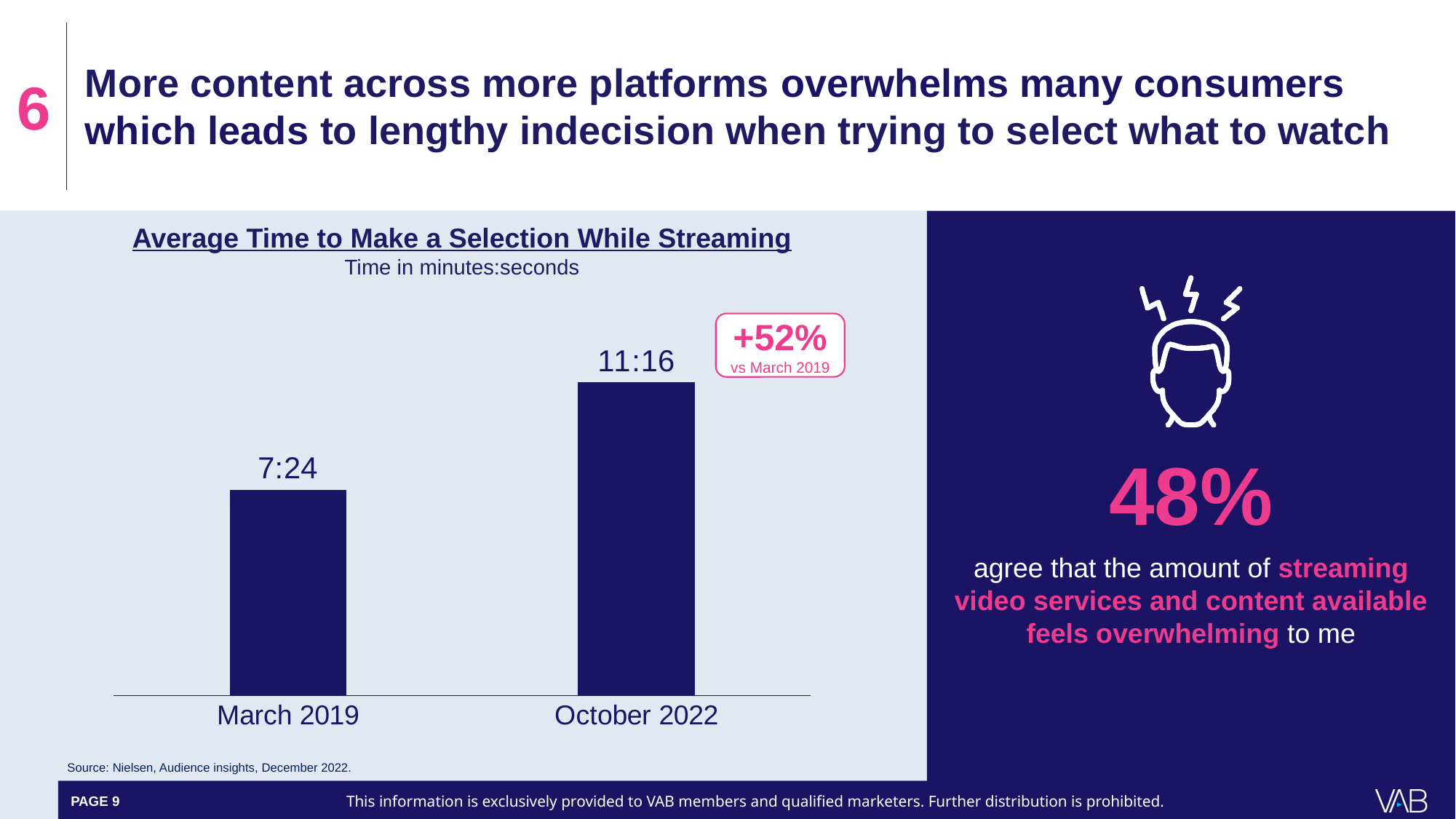
In what units is the time in the chart expressed? minutes:seconds How many periods are shown in the chart? 2 What percentage change versus March 2019 is annotated on the chart? +52% What is the average time to make a selection while streaming in March 2019? 7:24 Which period has the higher average time to make a selection while streaming? October 2022 Does the average time to make a selection rise or fall from March 2019 to October 2022? Rise Which period has the lower average time to make a selection while streaming? March 2019 Is the average selection time larger in March 2019 or in October 2022? October 2022 What type of chart is used to show the average time to make a selection while streaming? Bar chart What is the average time to make a selection while streaming in October 2022? 11:16 By how much did the average time to make a selection increase from March 2019 to October 2022, in minutes:seconds? 3:52